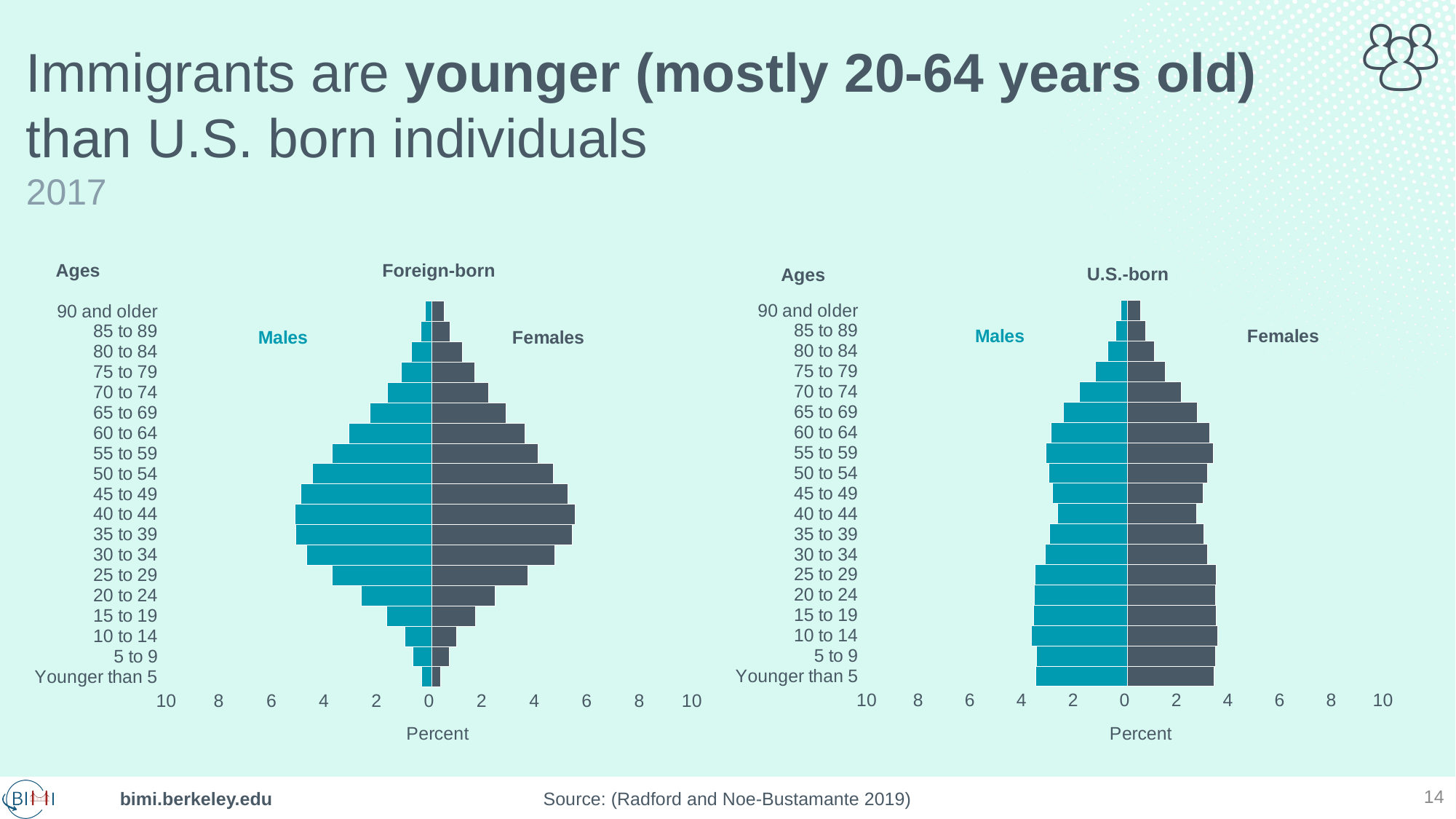
How many age groups are listed on the Foreign-born chart? 19 What kind of chart is the Foreign-born chart? bar chart In the Foreign-born chart, is the value for Males aged 15 to 19 greater or less than 2? less How many series does the U.S.-born chart show? 2 What is the x-axis label on the U.S.-born chart? Percent In the U.S.-born chart, is the value for Females aged 90 and older greater or less than 2? less In the Foreign-born chart, is the value for Males aged 40 to 44 greater or less than 4? greater In the Foreign-born chart, which is larger for Males: the 40 to 44 group or the 20 to 24 group? 40 to 44 For Males aged Younger than 5, which chart shows the larger value: Foreign-born or U.S.-born? U.S.-born